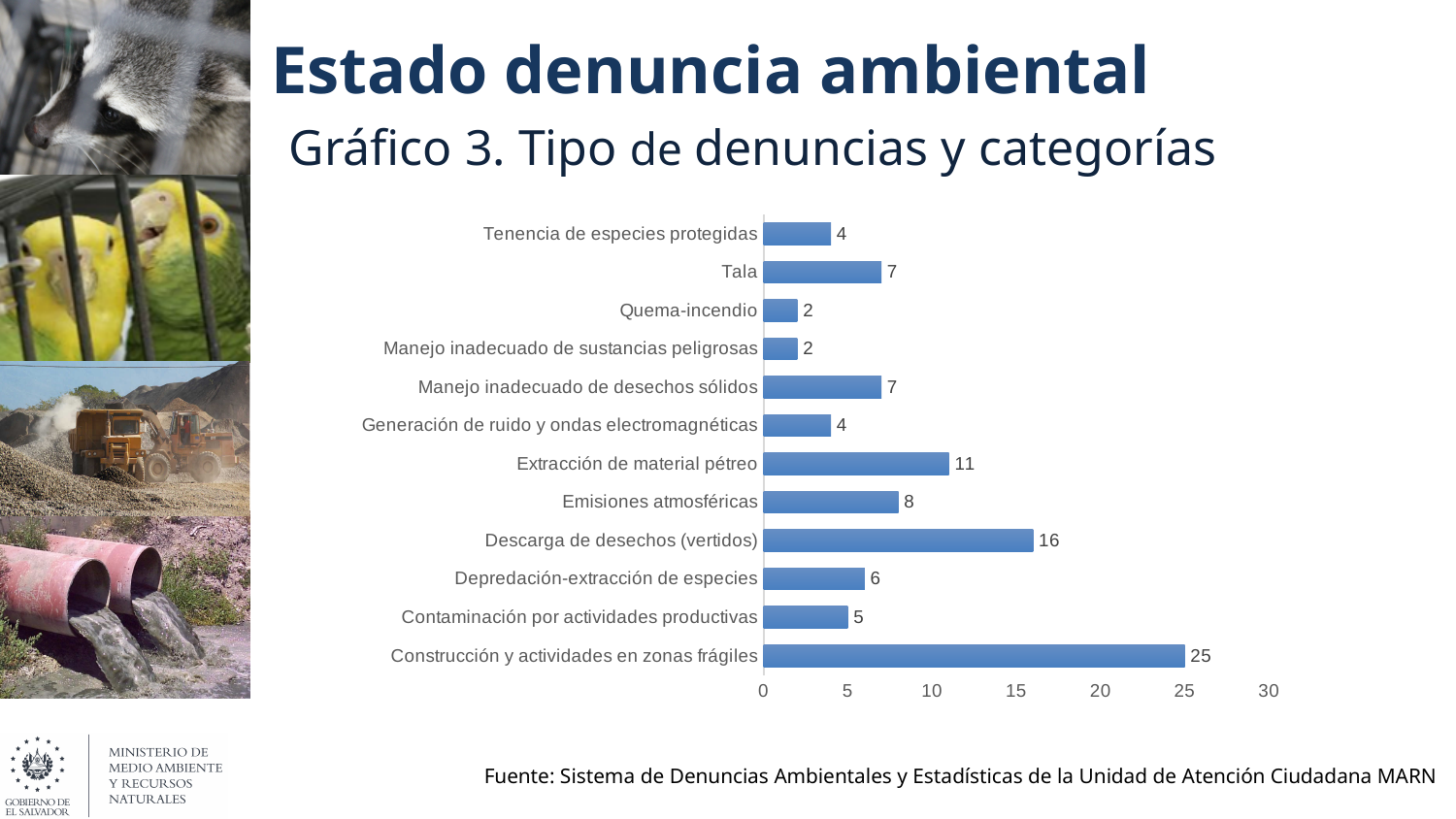
What is the value for Tala? 7 What is the value for Construcción y actividades en zonas frágiles? 25 How many categories are shown in the chart? 12 What kind of chart is shown on the slide? Bar chart Is the value for Extracción de material pétreo greater or less than 10? greater What is the value for Descarga de desechos (vertidos)? 16 What is the title of the chart? Gráfico 3. Tipo de denuncias y categorías What is the difference between Tala and Tenencia de especies protegidas? 3 Which category has the highest value? Construcción y actividades en zonas frágiles Which is larger, Emisiones atmosféricas or Depredación-extracción de especies? Emisiones atmosféricas What is the value for Extracción de material pétreo? 11 What is the difference between Construcción y actividades en zonas frágiles and Descarga de desechos (vertidos)? 9